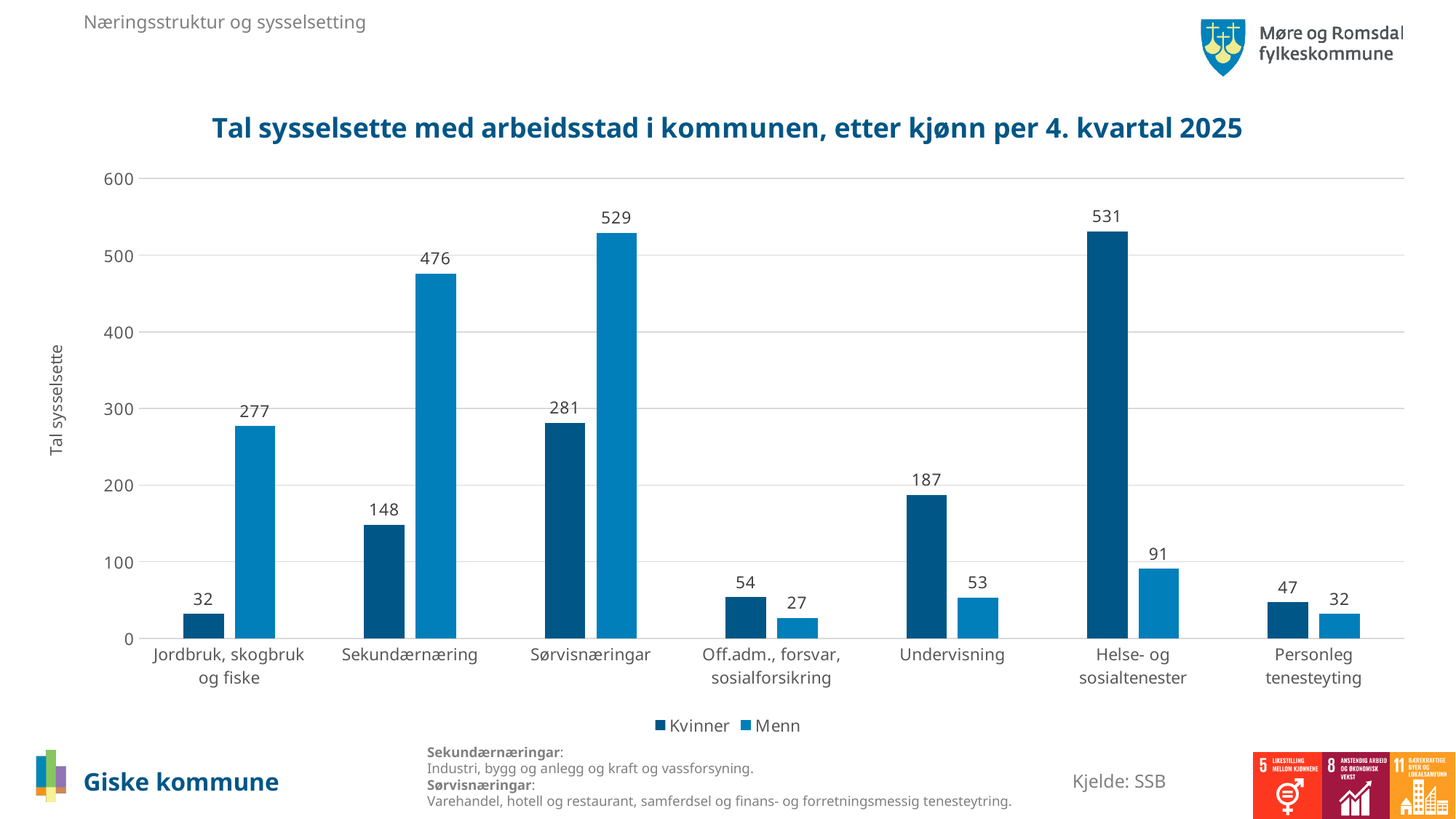
How many categories are shown on the x axis? 7 Which category has the highest value for Menn? Sørvisnæringar What is the value for Menn in Sekundærnæring? 476 Which is larger in Off.adm., forsvar, sosialforsikring: Kvinner or Menn? Kvinner How many series does the legend list? 2 What is the value for Kvinner in Helse- og sosialtenester? 531 What kind of chart is shown? Bar chart What is the difference between Menn and Kvinner in Sørvisnæringar? 248 What is the total of Kvinner and Menn in Personleg tenesteyting? 79 Is the value for Menn in Jordbruk, skogbruk og fiske greater or less than 200? greater What is the value for Kvinner in Undervisning? 187 Which category has the lowest value for Kvinner? Jordbruk, skogbruk og fiske